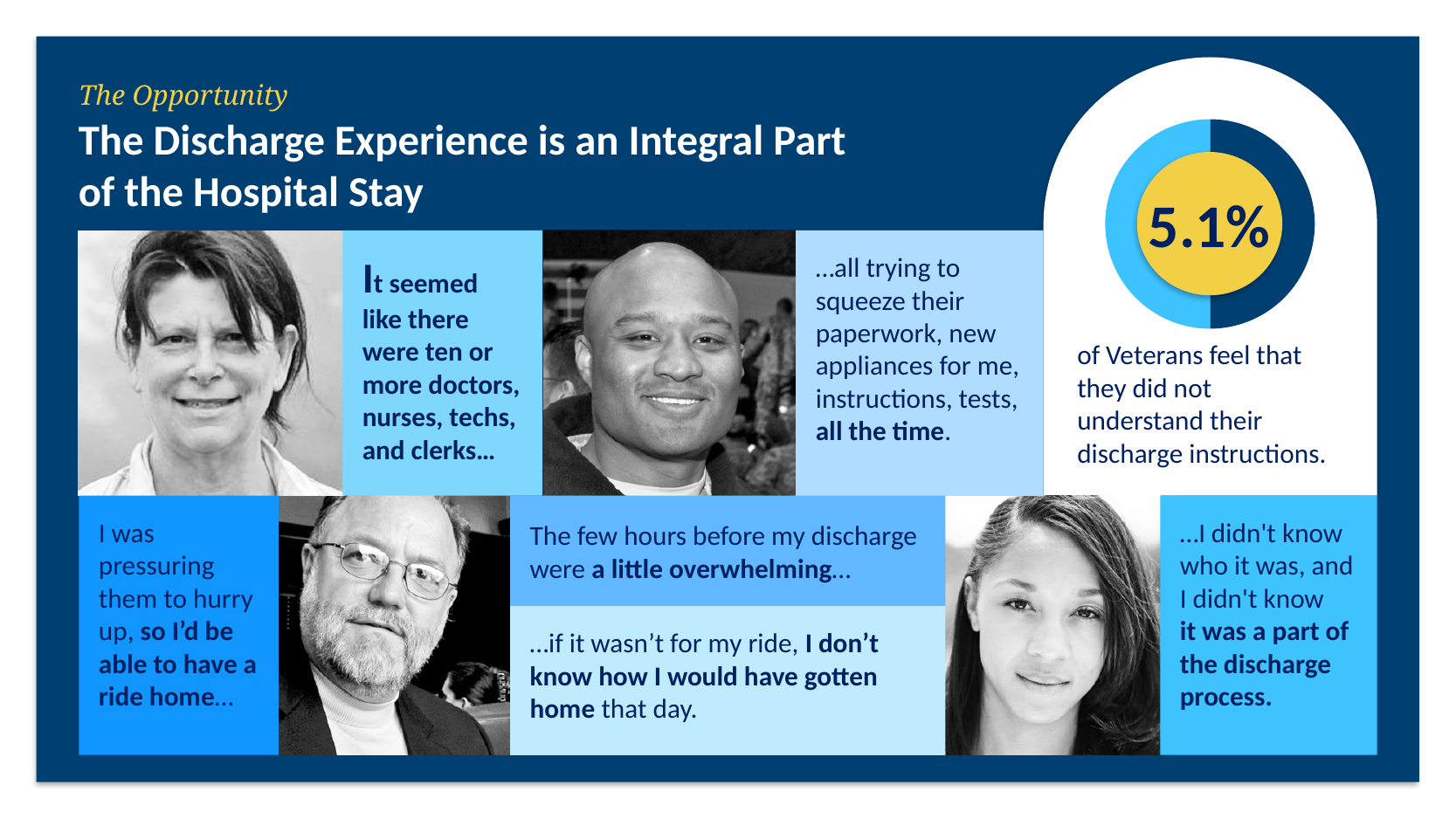
What percentage is printed in the center of the donut chart? 5.1% What colour is the central circle of the donut chart where the percentage is printed? Yellow How many coloured segments make up the ring of the donut chart? 2 According to the donut chart, what share of Veterans feel that they did not understand their discharge instructions? 5.1% What kind of chart is shown on the right side of the slide? Pie (donut) chart What group of people does the donut chart's 5.1% figure refer to? Veterans